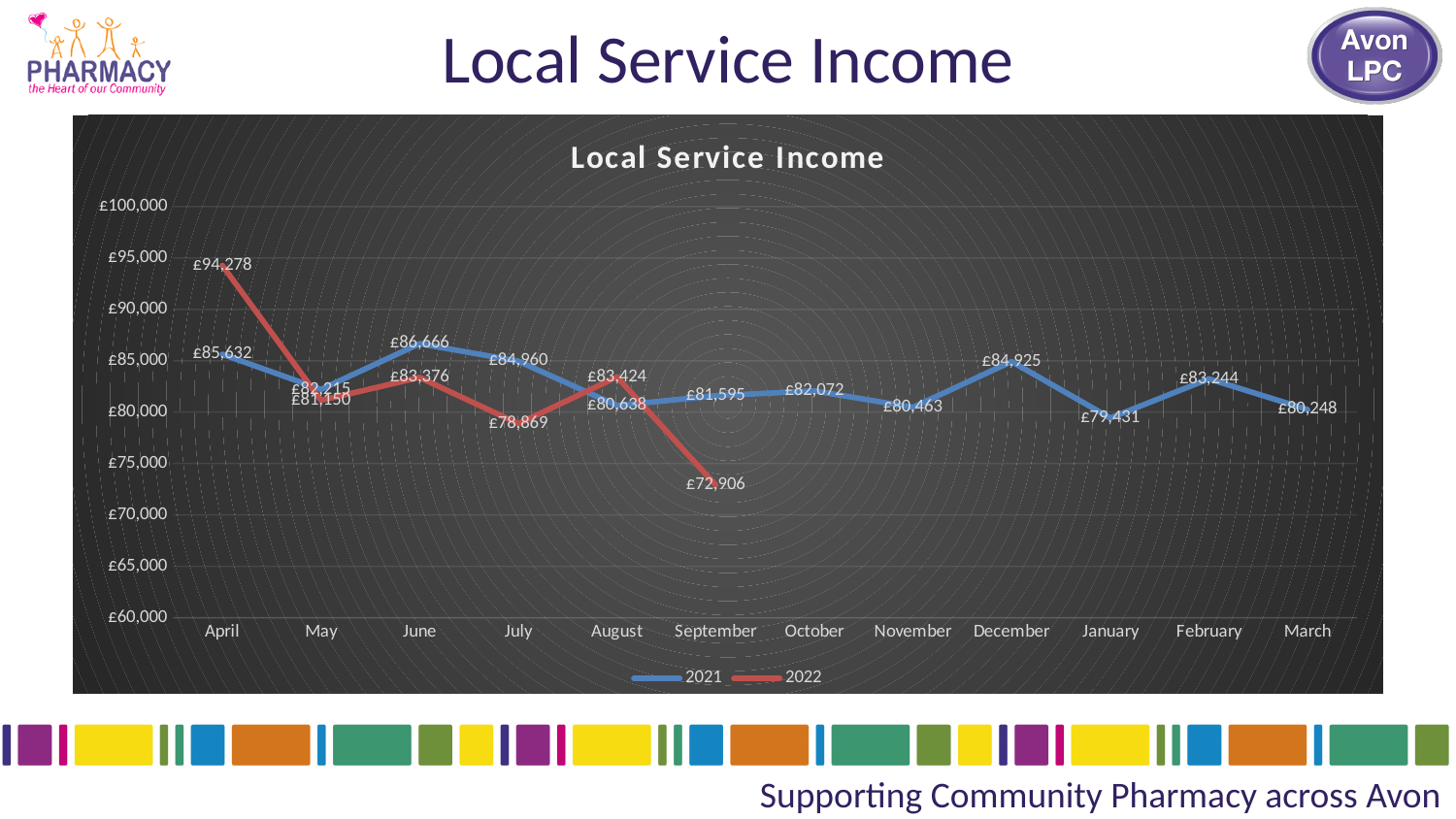
What is the Local Service Income for June in the 2021 series? £86,666 Does the 2022 series rise or fall from August to September? fall Which month has the lowest value in the 2022 series? September Is the 2022 value for September greater or less than £75,000? less What is the Local Service Income for April in the 2022 series? £94,278 How many months are shown on the x axis? 12 How many series does the legend list? 2 In August, which series has the higher value, 2021 or 2022? 2022 What kind of chart is shown on the slide? line chart What is the difference between the 2022 values for April and September? £21,372 What is the Local Service Income for January in the 2021 series? £79,431 Which month has the highest value in the 2021 series? June